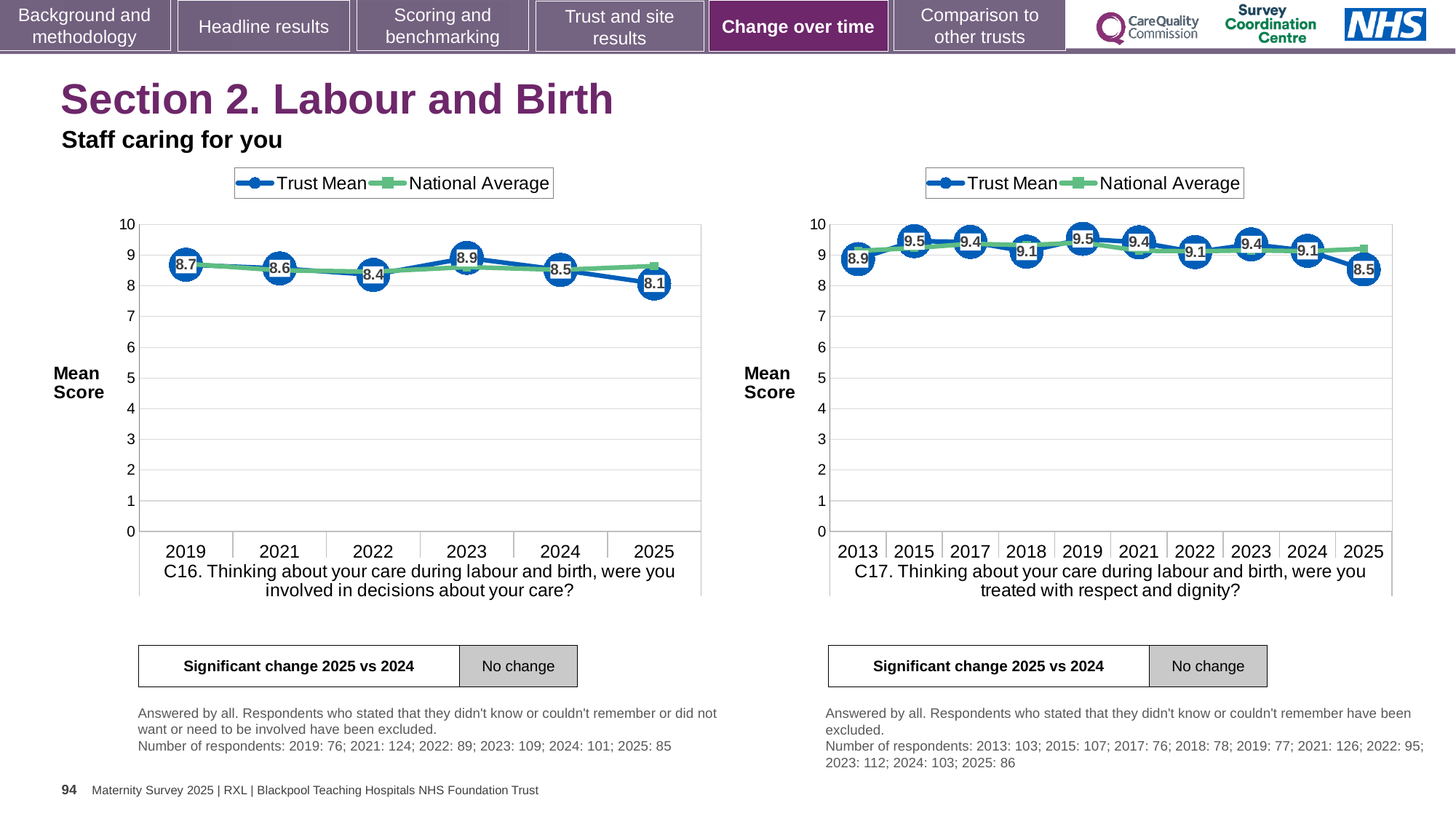
In the C17 chart (right), what is the Trust Mean score for 2013? 8.9 What type of chart is the C16 chart (left)? line chart In the C17 chart (right), which year has the lowest Trust Mean score? 2025 In the C16 chart (left), what is the Trust Mean score for 2023? 8.9 In the C16 chart (left), what is the Trust Mean score for 2025? 8.1 In the C16 chart (left), which year has the lowest Trust Mean score? 2025 In the C16 chart (left), what is the difference between the Trust Mean scores for 2019 and 2025? 0.6 In the C17 chart (right), is the Trust Mean score for 2015 larger or smaller than for 2018? larger In the C16 chart (left), which year has the highest Trust Mean score? 2023 In the C16 chart (left), how many years are shown on the x axis? 6 In the C17 chart (right), what is the Trust Mean score for 2025? 8.5 In the C17 chart (right), how many series does the legend list? 2